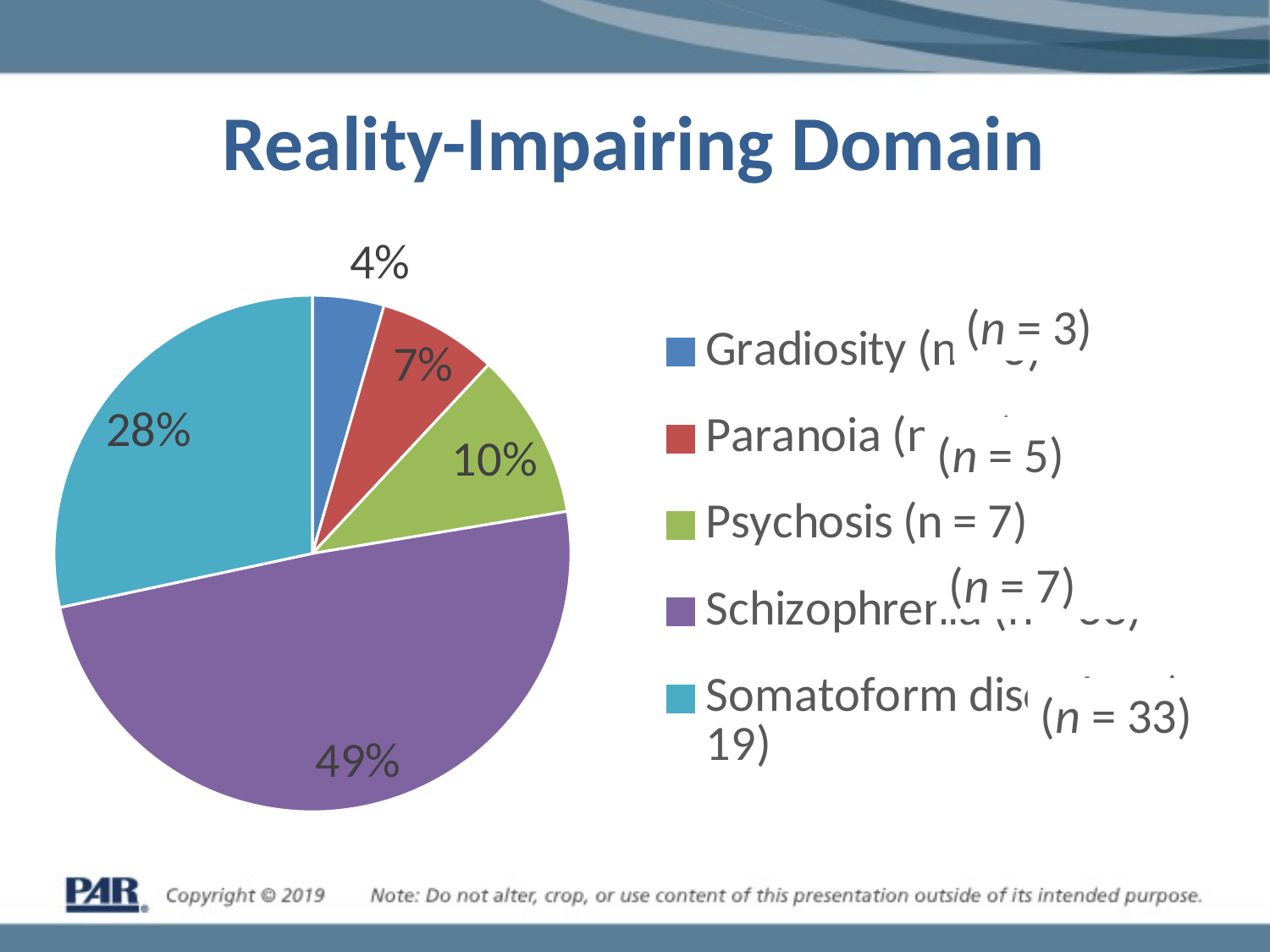
What percentage of the pie is the Psychosis slice? 10% Which slice is larger, Paranoia or Psychosis? Psychosis What kind of chart is shown on the slide? Pie chart Which category has the smallest slice of the pie? Gradiosity How many entries does the legend list? 5 How many slices does the pie chart have? 5 What is the difference in percentage points between the Schizophrenia slice (49%) and the Somatoform slice (28%)? 21 percentage points What percentage of the pie is the Gradiosity slice? 4% What percentage of the pie is the Paranoia slice? 7% Which category has the largest slice of the pie? Schizophrenia What is the title of the chart on the slide? Reality-Impairing Domain What share of the pie does the Schizophrenia slice represent? 49%